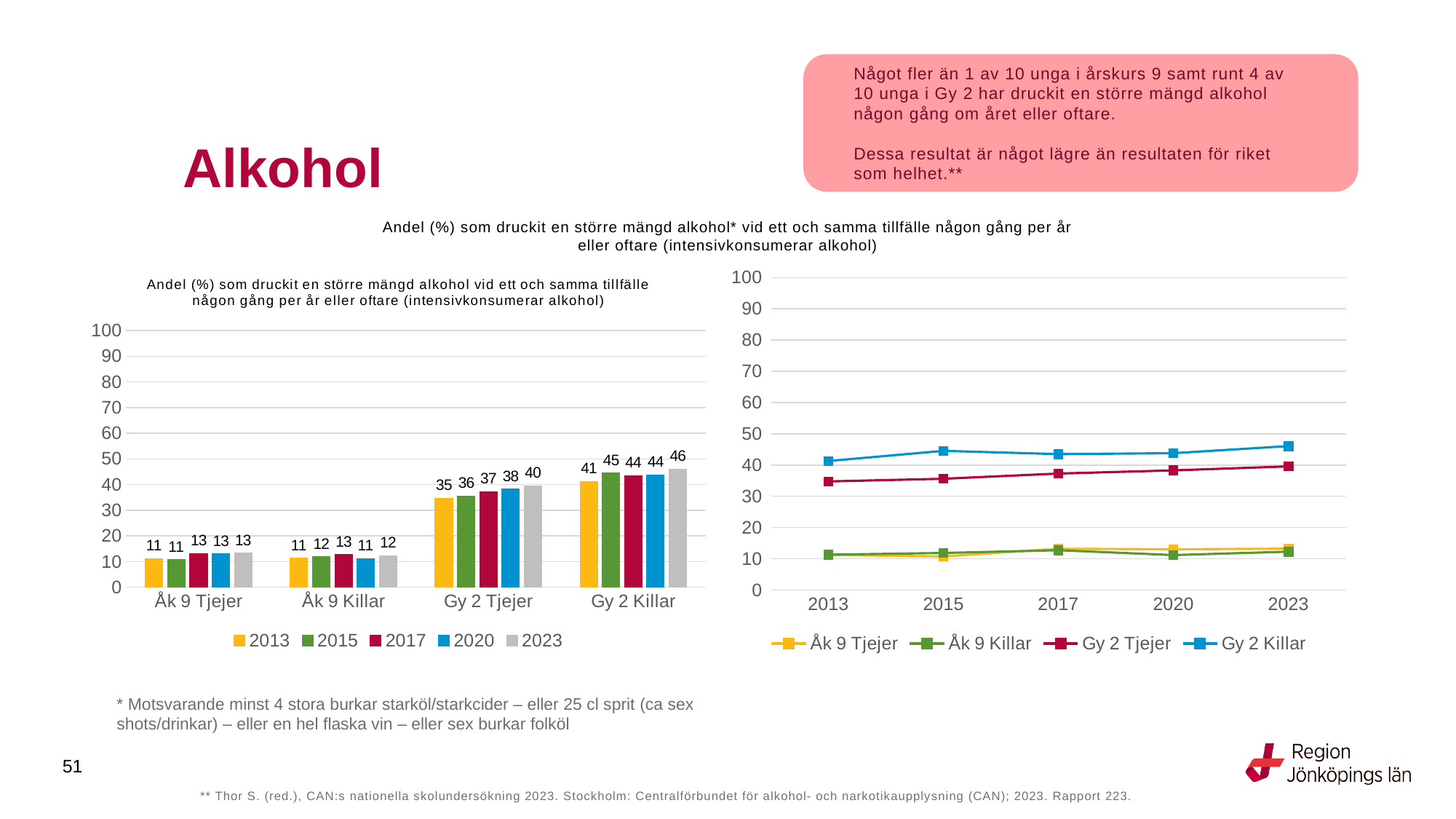
In the right line chart, is the value for Gy 2 Killar in 2023 greater or less than 40? greater How many categories are shown on the x axis of the left bar chart? 4 In the left bar chart, what is the value for Gy 2 Killar in 2023? 46 In the left bar chart, what is the difference between Gy 2 Killar and Gy 2 Tjejer in 2023? 6 In the right line chart, is the value for Åk 9 Killar in 2013 greater or less than 20? less What kind of chart is the chart on the right side of the slide? Line chart In the left bar chart, what is the value for Gy 2 Tjejer in 2013? 35 In the left bar chart, which category has the highest value for 2023? Gy 2 Killar In the left bar chart, which is larger for Gy 2 Killar: the 2015 value or the 2017 value? 2015 How many series does the legend of the left bar chart list? 5 In the left bar chart, what is the value for Åk 9 Killar in 2020? 11 In the right line chart, does the Gy 2 Tjejer line rise or fall from 2013 to 2023? Rise